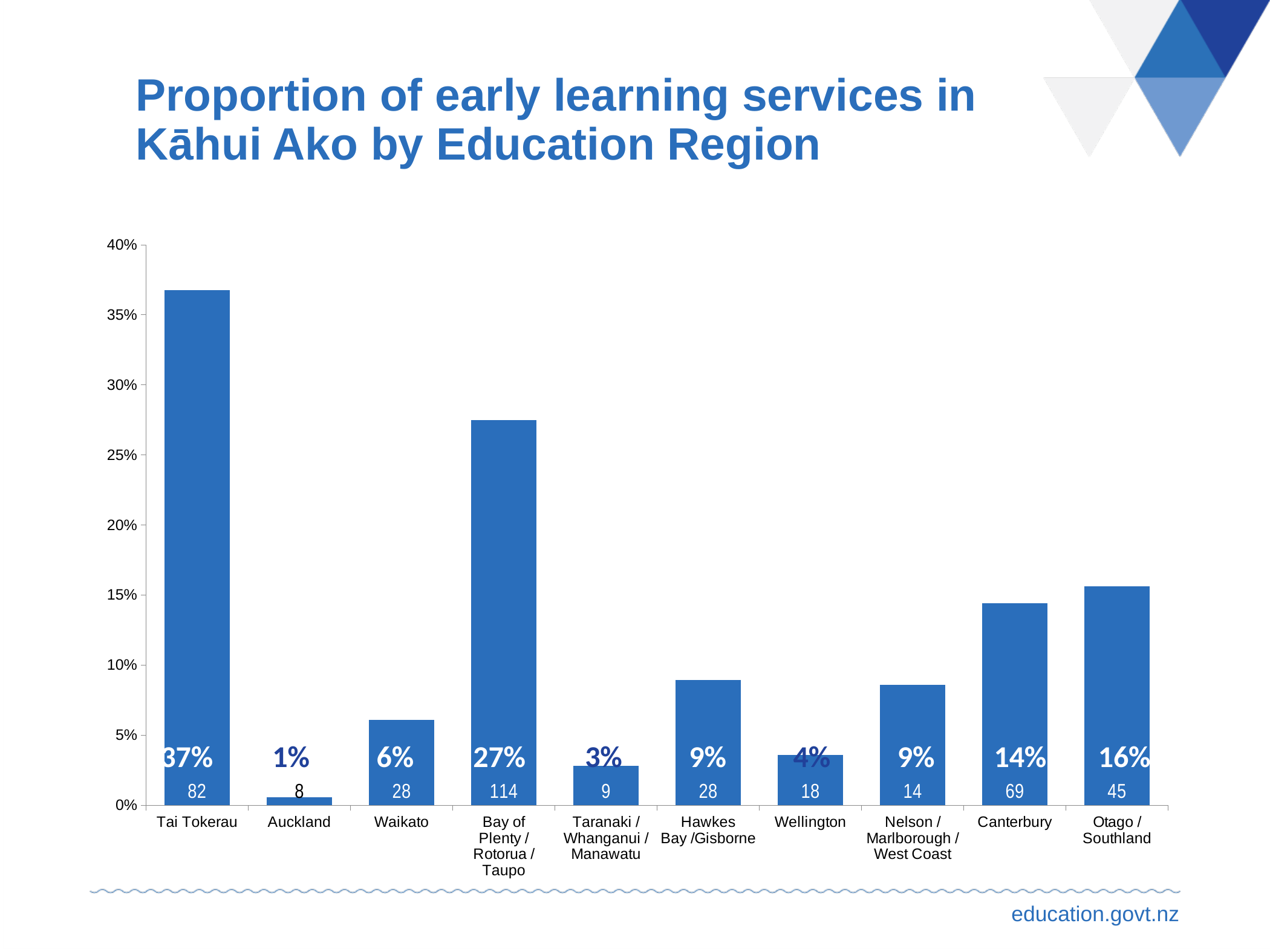
What is the proportion shown for Bay of Plenty / Rotorua / Taupo? 27% Which education region has the lowest proportion of early learning services in Kāhui Ako? Auckland Which education region has the highest proportion of early learning services in Kāhui Ako? Tai Tokerau Is the value for Hawkes Bay /Gisborne greater or less than 5%? greater What number is printed on the Canterbury bar? 69 What kind of chart is shown on the slide? Bar chart What is the proportion of early learning services in Kāhui Ako for Tai Tokerau? 37% Is the value for Wellington greater or less than 5%? less What is the difference in percentage points between Tai Tokerau and Bay of Plenty / Rotorua / Taupo? 10% What is the title of the chart on the slide? Proportion of early learning services in Kāhui Ako by Education Region Which has a higher proportion, Otago / Southland or Canterbury? Otago / Southland How many education regions are shown on the chart? 10